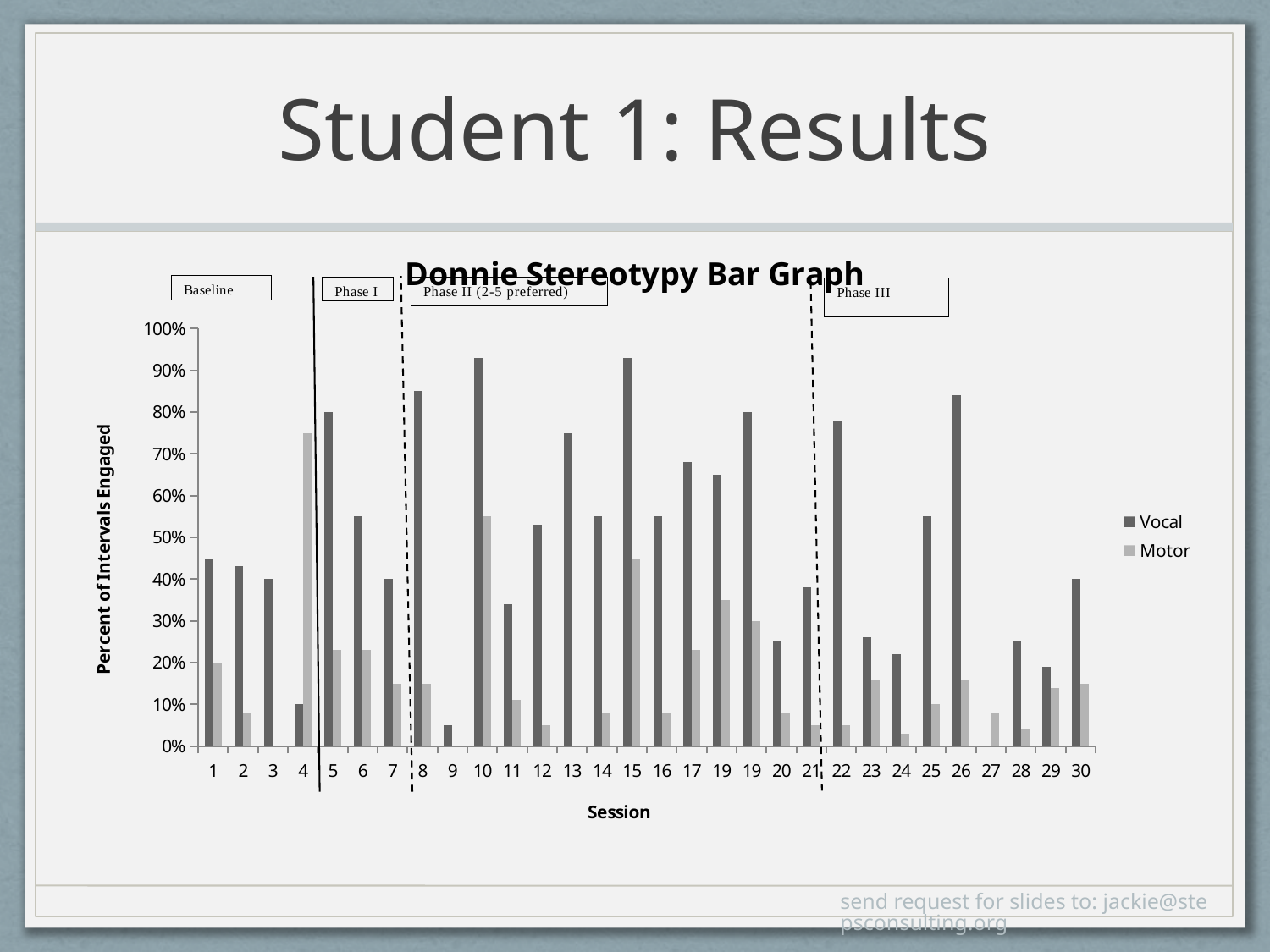
Is the Motor value for session 4 greater or less than 70%? greater Which session has the highest Motor value? 4 Is the Vocal value for session 1 greater or less than 40%? greater What kind of chart is shown on the slide? bar chart How many sessions are shown along the x axis? 30 What are the two series named in the legend? Vocal and Motor Which is larger, the Vocal value for session 10 or the Vocal value for session 11? session 10 Is the Vocal value for session 20 greater or less than 30%? less What is the title of the chart? Donnie Stereotypy Bar Graph How many series does the legend list? 2 In session 4, which is larger, the Vocal value or the Motor value? Motor